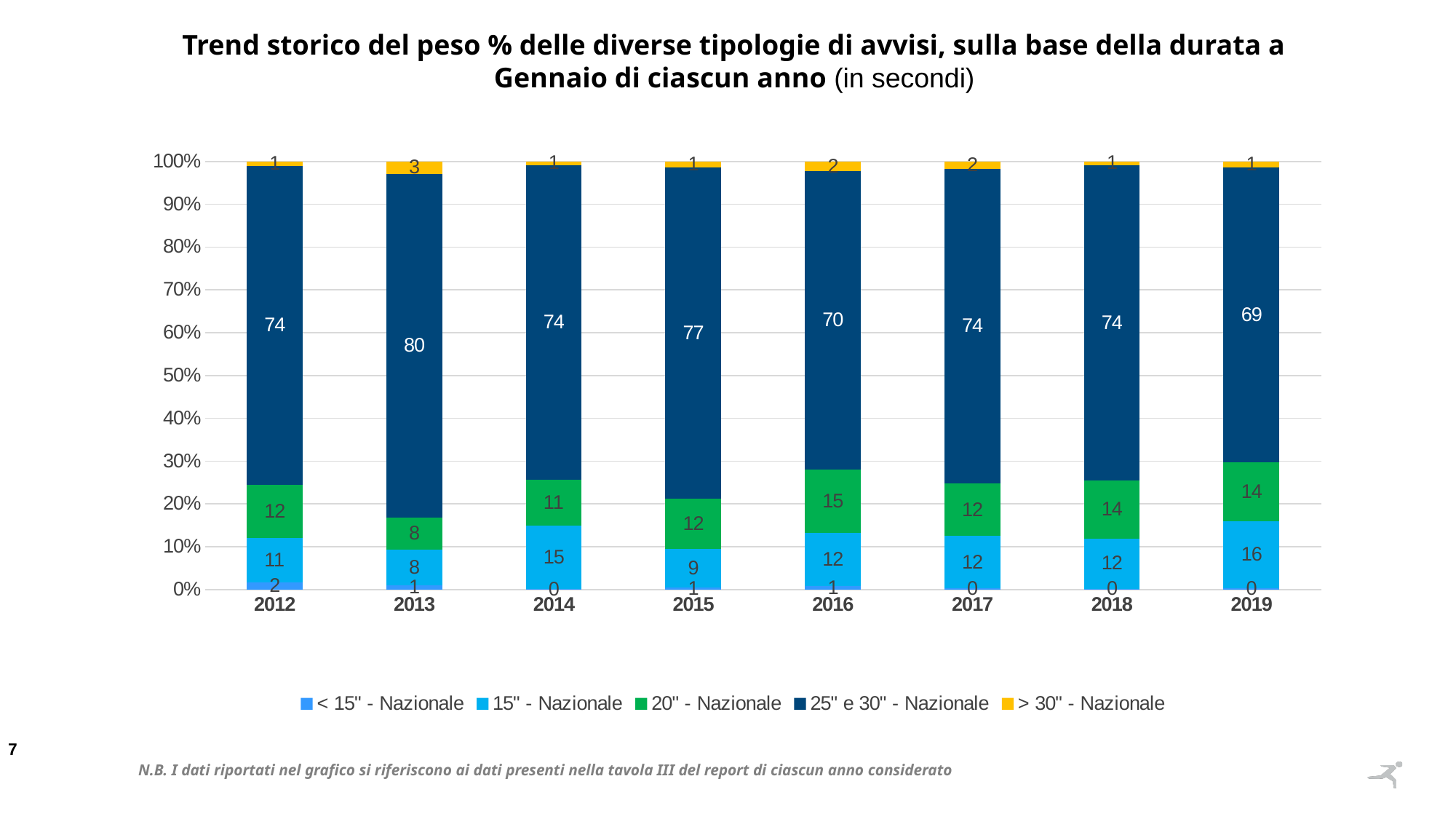
What is the value for the "15'' - Nazionale" series in 2019? 16 What is the difference between the "25'' e 30'' - Nazionale" values in 2013 and 2019? 11 In which year is the "25'' e 30'' - Nazionale" series highest? 2013 How many years are shown on the x axis? 8 How many series does the legend list? 5 What kind of chart is shown on the slide? Stacked bar chart Which is larger: the "15'' - Nazionale" value in 2014 or in 2015? 2014 Which colour represents the "> 30'' - Nazionale" series in the legend? Yellow What is the value for the "20'' - Nazionale" series in 2016? 15 In which year is the "25'' e 30'' - Nazionale" series lowest? 2019 What is the value for the "> 30'' - Nazionale" series in 2013? 3 What is the value for the "25'' e 30'' - Nazionale" series in 2013? 80